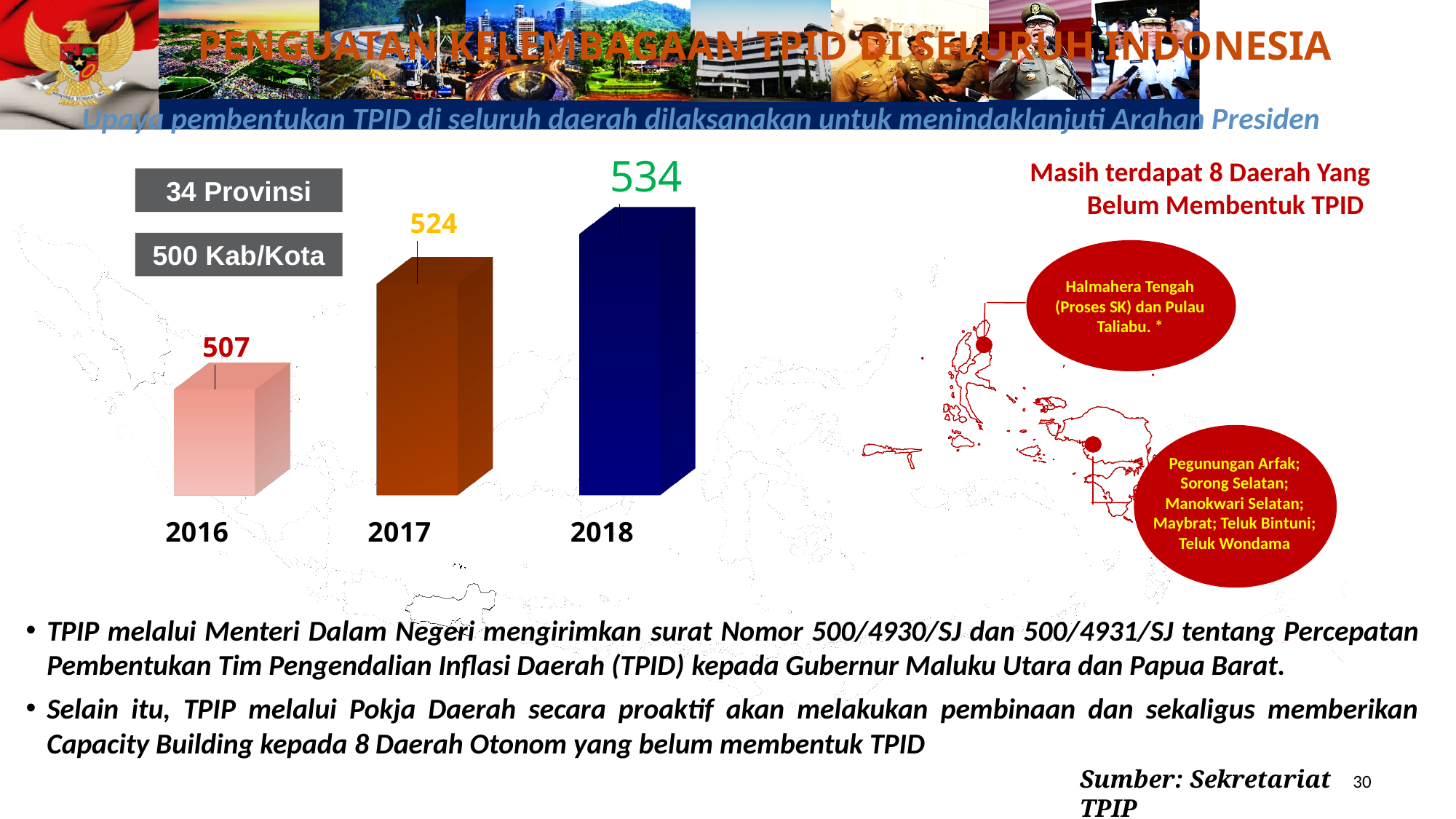
Which is larger, the value for 2017 or the value for 2018? 2018 How many years are shown in the bar chart? 3 What is the value shown for 2016 in the bar chart? 507 What is the value shown for 2018 in the bar chart? 534 What kind of chart is shown on the slide? bar chart What is the difference between the values for 2017 and 2016? 17 Which year has the highest value in the bar chart? 2018 Do the values rise or fall from 2016 to 2018? rise Which year has the lowest value in the bar chart? 2016 What is the difference between the values for 2018 and 2017? 10 What is the difference between the values for 2018 and 2016? 27 What is the value shown for 2017 in the bar chart? 524